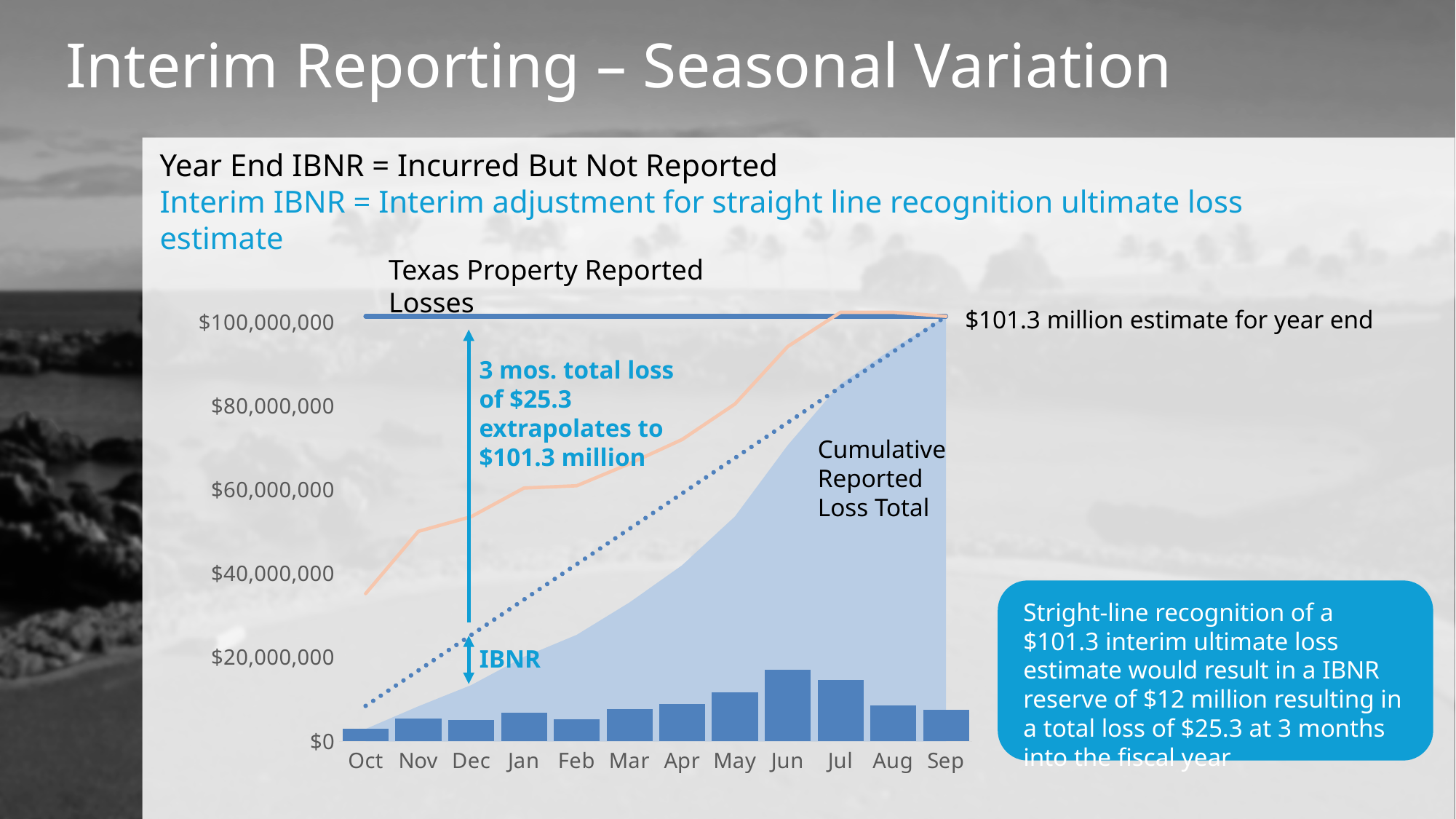
Which month has the highest monthly reported loss bar? Jun Which month has the lowest monthly reported loss bar? Oct According to the chart annotation, what is the 3-month total loss that extrapolates to $101.3 million? $25.3 Does the Cumulative Reported Loss Total rise or fall from Oct to Sep? rise What is the year-end estimate annotated on the chart? $101.3 million Is the monthly bar for Jun greater or less than $20,000,000? less Is the monthly bar for May higher or lower than the bar for Apr? higher What is the title of the chart? Texas Property Reported Losses What kind of chart is used to show the monthly reported losses? bar chart Is the monthly bar for Jun higher or lower than the bar for Jul? higher Is the Cumulative Reported Loss Total at Mar greater or less than $40,000,000? less How many months are shown on the x axis of the chart? 12